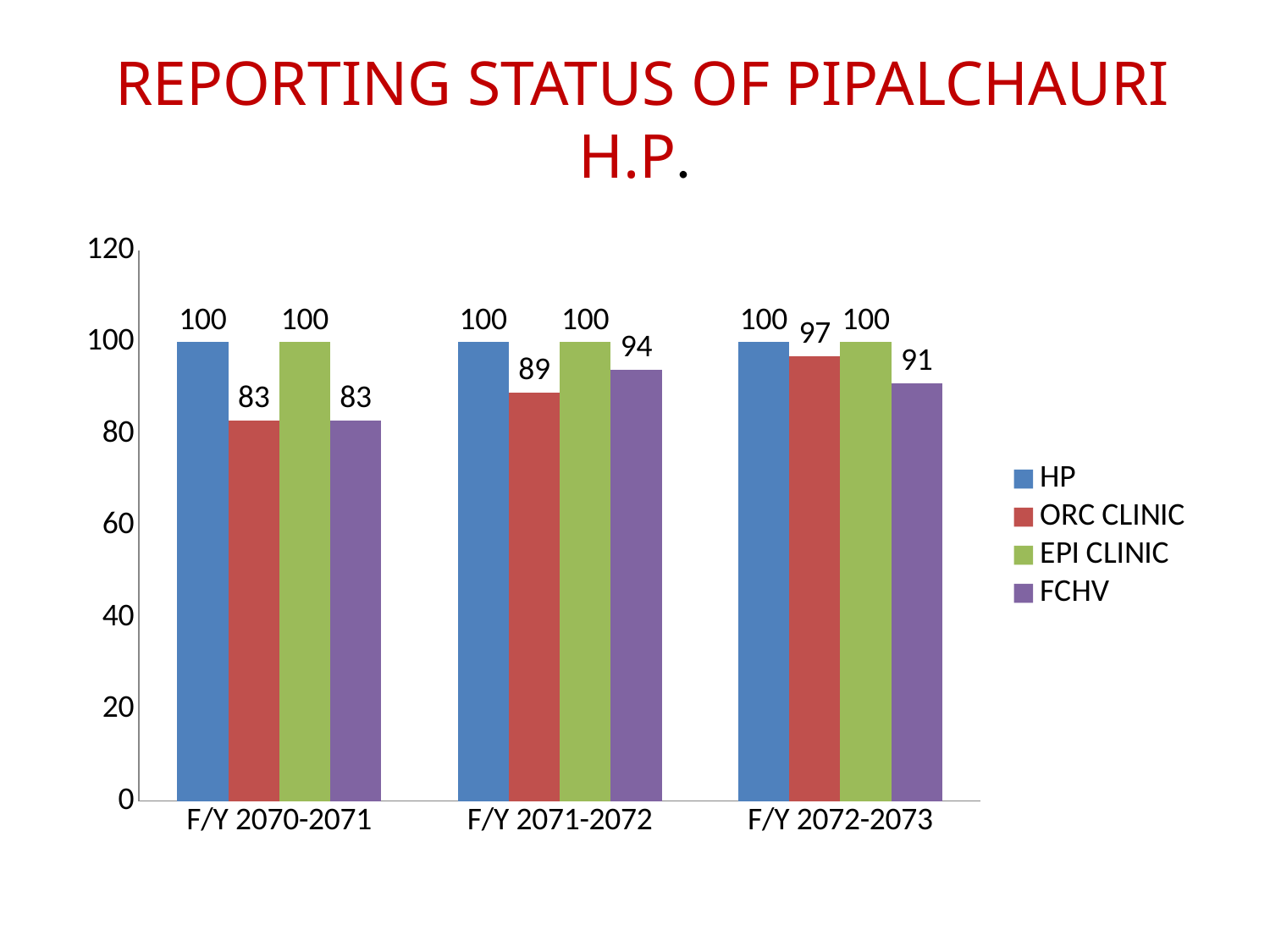
Which fiscal year has the highest value for ORC CLINIC? F/Y 2072-2073 What is the value for ORC CLINIC in F/Y 2072-2073? 97 What is the value for HP in F/Y 2072-2073? 100 Which fiscal year has the lowest value for FCHV? F/Y 2070-2071 How many fiscal years are shown on the x axis? 3 How many series does the legend list? 4 What kind of chart is shown on the slide? Bar chart What is the value for FCHV in F/Y 2071-2072? 94 What is the value for ORC CLINIC in F/Y 2070-2071? 83 Do the ORC CLINIC values rise or fall from F/Y 2070-2071 to F/Y 2072-2073? Rise Which is larger in F/Y 2072-2073, the ORC CLINIC value or the FCHV value? ORC CLINIC What is the difference between the HP value and the ORC CLINIC value in F/Y 2071-2072? 11